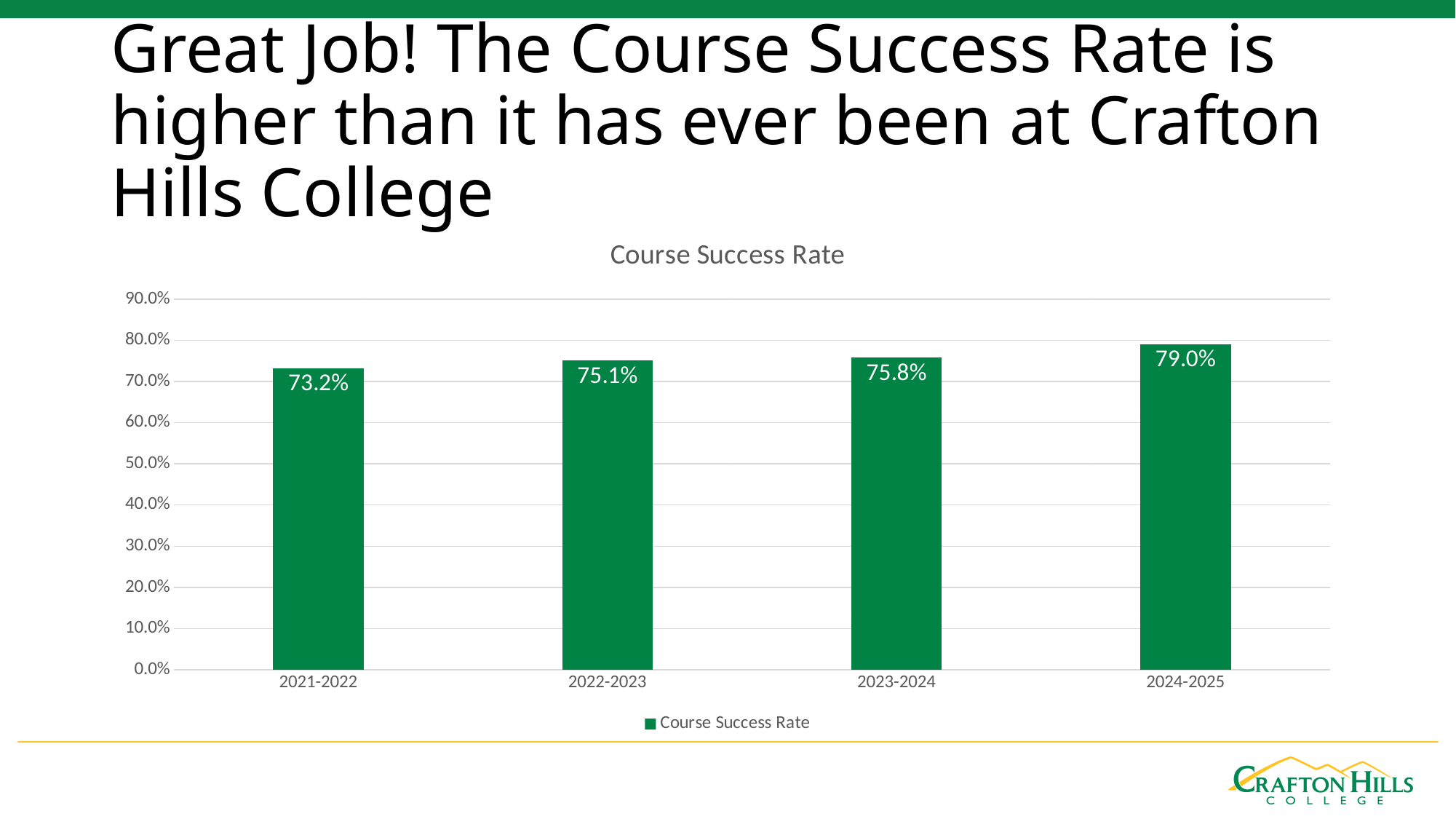
Which academic year has the lowest Course Success Rate? 2021-2022 Which academic year has the highest Course Success Rate? 2024-2025 Which year has a higher Course Success Rate, 2022-2023 or 2023-2024? 2023-2024 What kind of chart is shown on the slide? bar chart What is the difference in Course Success Rate between 2024-2025 and 2021-2022? 5.8% What is the Course Success Rate for 2022-2023? 75.1% What is the Course Success Rate for 2021-2022? 73.2% What is the Course Success Rate for 2024-2025? 79.0% How many series does the legend list? 1 How many academic years are shown on the chart? 4 Does the Course Success Rate rise or fall from 2021-2022 to 2024-2025? rise Is the Course Success Rate for 2024-2025 greater or less than 80.0%? less